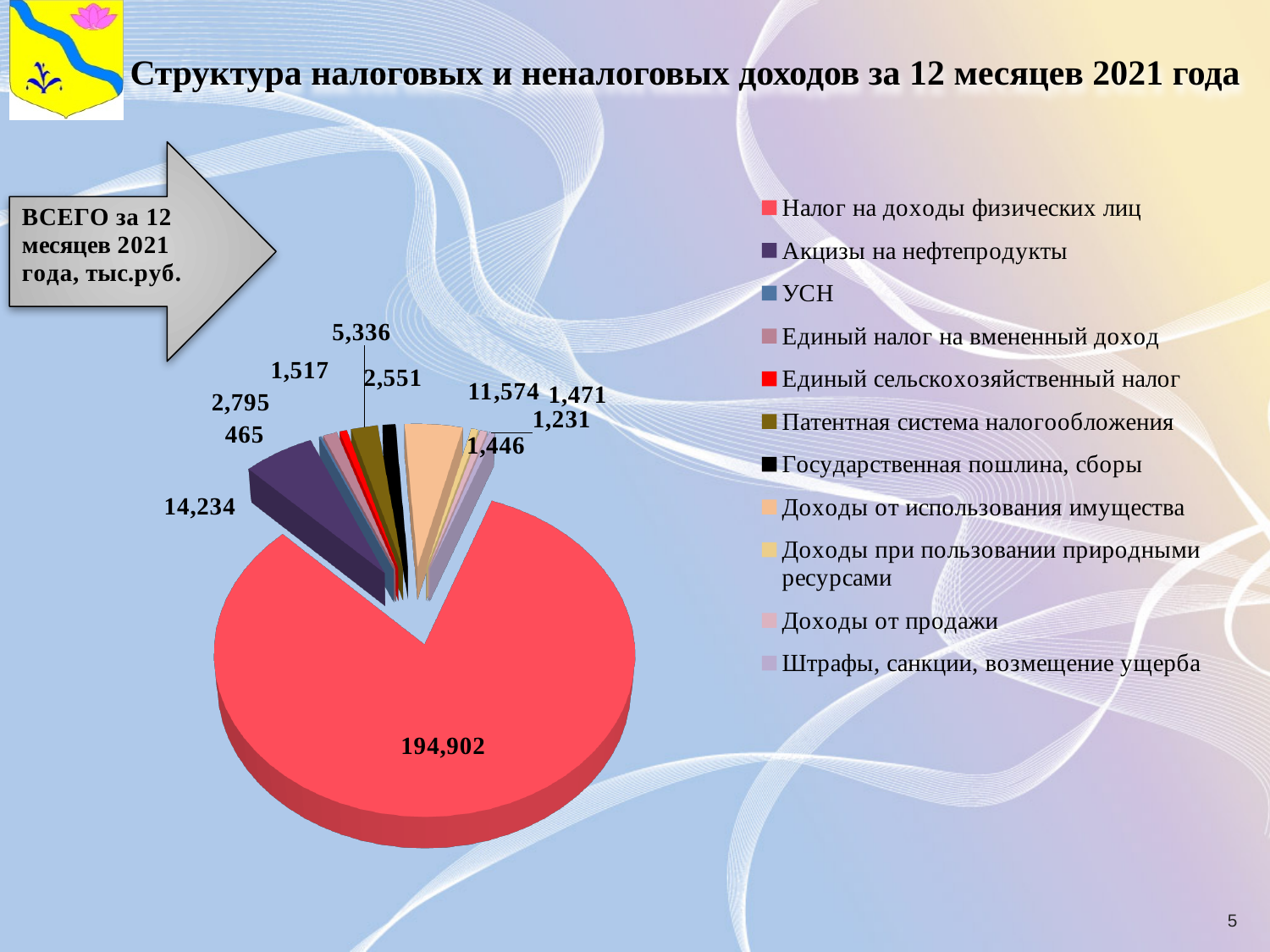
In what units are the values of the pie chart given, according to the arrow label? тыс.руб. Which category has the largest slice of the pie? Налог на доходы физических лиц What is the value shown for Доходы от использования имущества? 11,574 How many slices does the pie chart have? 11 What is the value shown for Налог на доходы физических лиц? 194,902 What is the value shown for Акцизы на нефтепродукты? 14,234 What kind of chart is shown on the slide? Pie chart What is the title of the slide containing the pie chart? Структура налоговых и неналоговых доходов за 12 месяцев 2021 года Which is larger: Налог на доходы физических лиц or Акцизы на нефтепродукты? Налог на доходы физических лиц What is the difference between the values for Налог на доходы физических лиц and Акцизы на нефтепродукты? 180,668 How many categories does the legend of the pie chart list? 11